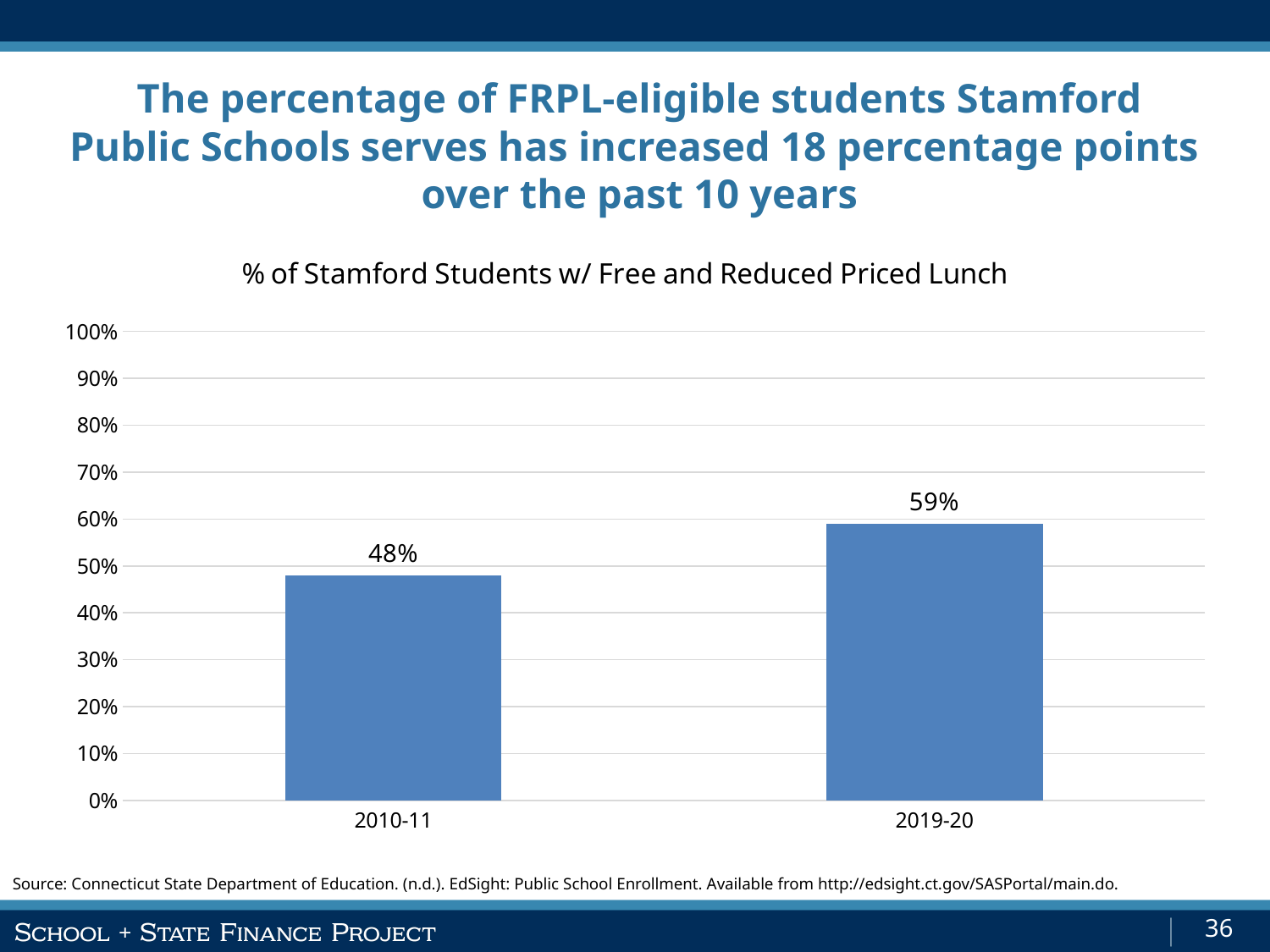
What is the difference in percentage points between 2019-20 and 2010-11? 11 Which year has the highest percentage of students with free and reduced priced lunch? 2019-20 What is the value for 2010-11? 48% Do the values rise or fall from 2010-11 to 2019-20? rise What is the title of the chart? % of Stamford Students w/ Free and Reduced Priced Lunch How many categories are shown on the x axis? 2 Is the value for 2010-11 greater or less than 50%? less Which year has the lowest percentage of students with free and reduced priced lunch? 2010-11 Is the value for 2019-20 greater or less than 50%? greater What is the value for 2019-20? 59% Which is larger, the value for 2010-11 or the value for 2019-20? 2019-20 What kind of chart is shown on the slide? bar chart